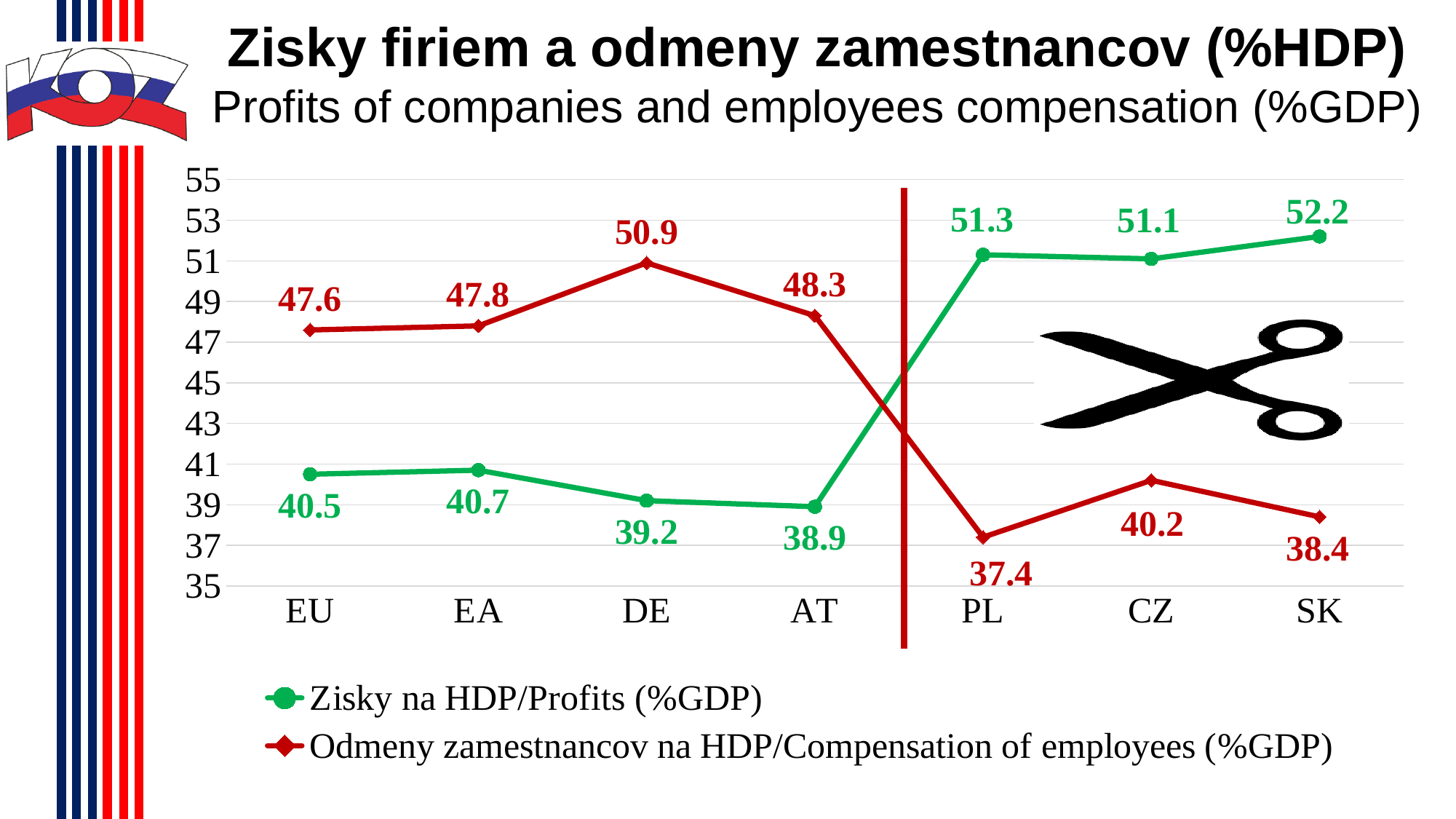
Which category has the highest value for Compensation of employees (%GDP)? DE What kind of chart is shown on the slide? Line chart What colour is the line for Profits (%GDP)? Green Which category has the lowest value for Profits (%GDP)? AT Which category has the lowest value for Compensation of employees (%GDP)? PL What is the value of Profits (%GDP) for AT? 38.9 What is the value of Compensation of employees (%GDP) for DE? 50.9 How many series does the legend list? 2 How many categories are shown on the x axis? 7 For DE, which is larger: Profits or Compensation of employees? Compensation of employees What is the value of Profits (%GDP) for SK? 52.2 What is the difference between Profits and Compensation of employees for SK? 13.8